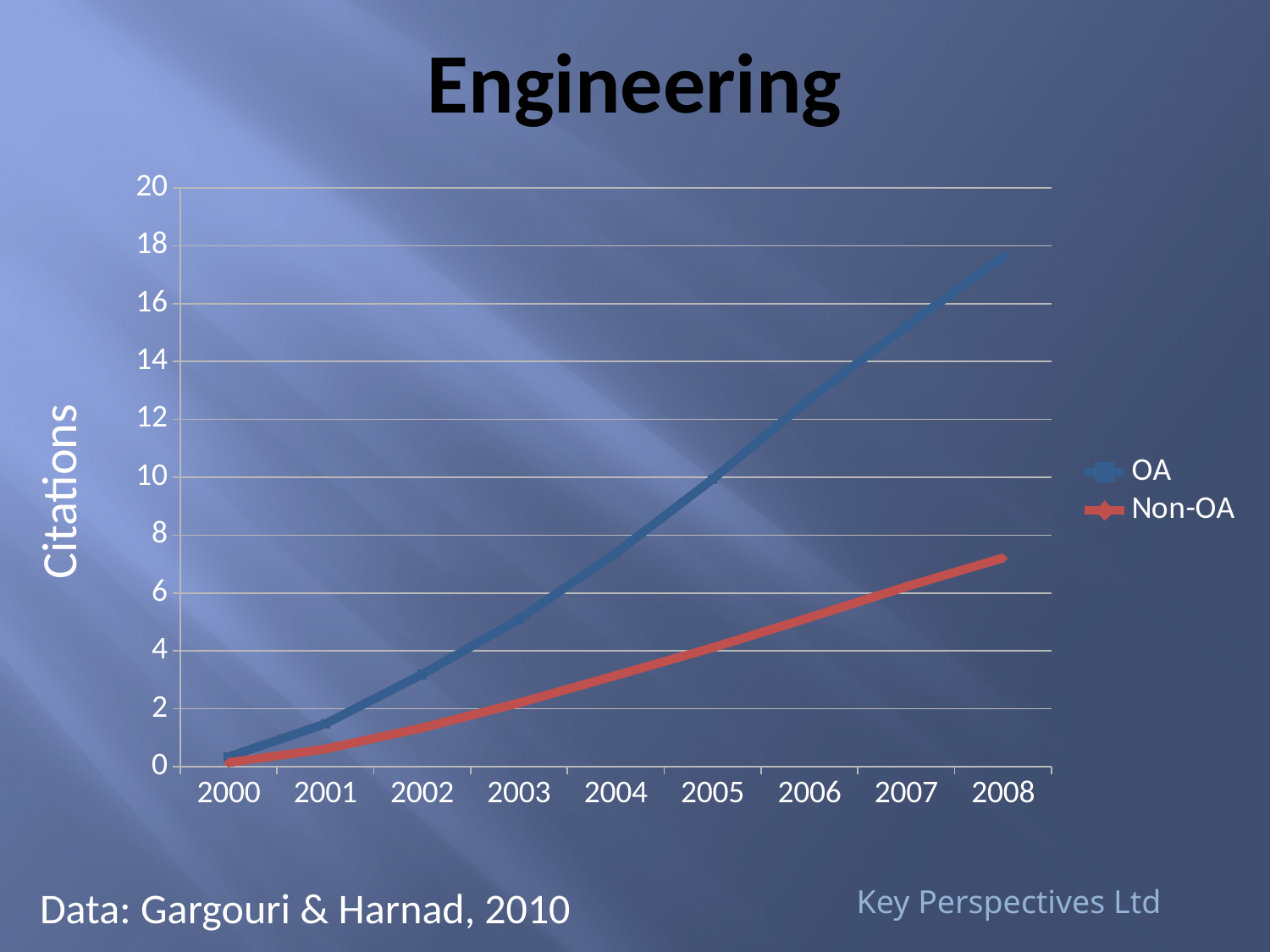
Is the OA value for 2006 greater or less than 12? greater What is the title of the chart? Engineering Which series has the higher value in 2008, OA or Non-OA? OA What are the two series named in the legend? OA and Non-OA Is the Non-OA value for 2008 greater or less than 8? less In which year does the OA series reach its highest value? 2008 What kind of chart is shown on the slide? line chart How many series does the legend list? 2 Is the Non-OA value for 2004 greater or less than 4? less How many years are shown along the x axis? 9 Do the OA citations rise or fall from 2000 to 2008? rise